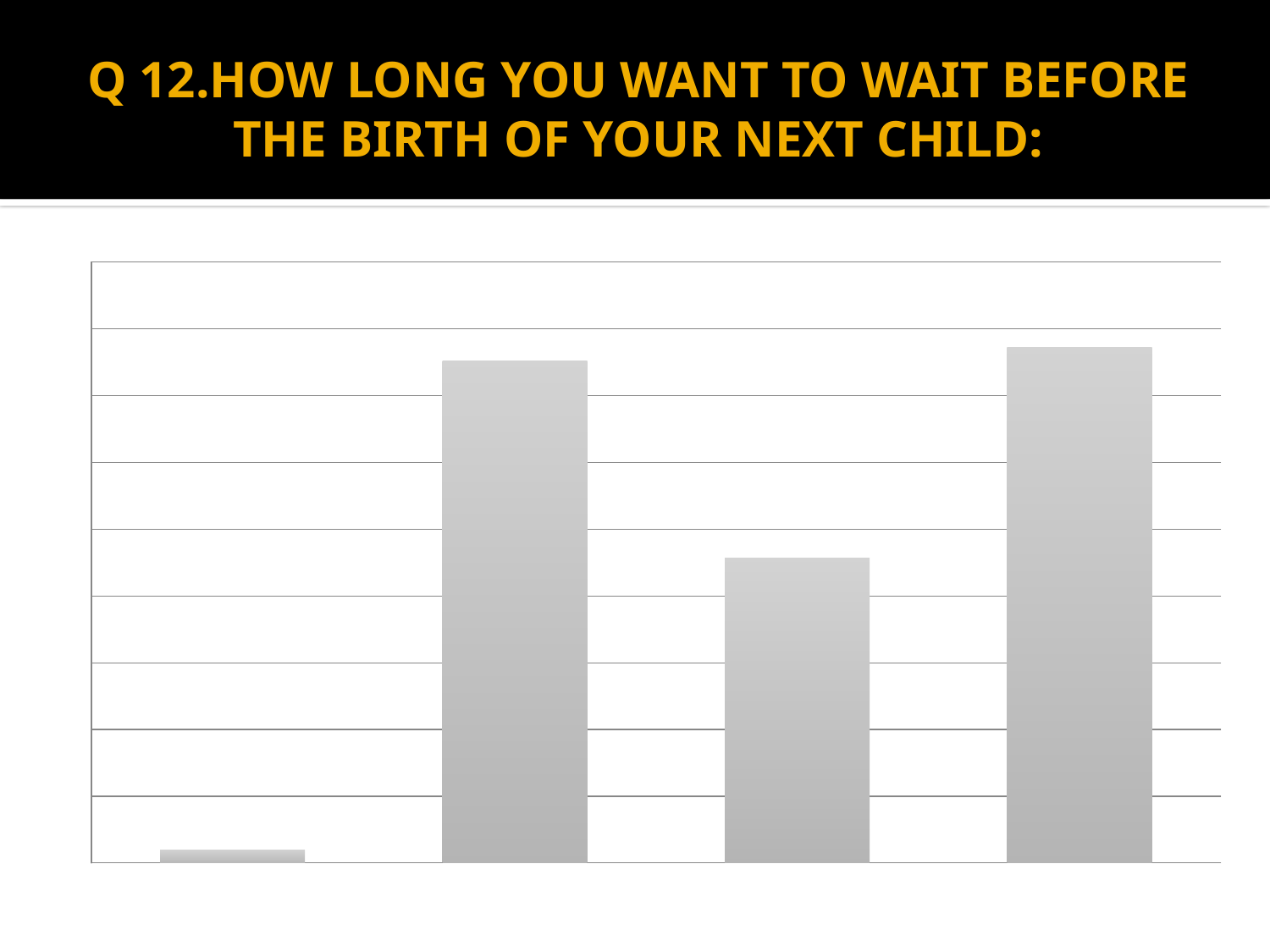
What kind of chart is shown on the slide? Bar chart Counting from the left, which bar is the tallest? The fourth bar Does the chart display a legend? No What is the title of the slide containing the chart? Q 12.HOW LONG YOU WANT TO WAIT BEFORE THE BIRTH OF YOUR NEXT CHILD: Counting from the left, which is taller: the second bar or the third bar? The second bar How many bars are plotted in the chart? 4 Counting from the left, which is taller: the first bar or the third bar? The third bar Counting from the left, which bar is the shortest? The first bar